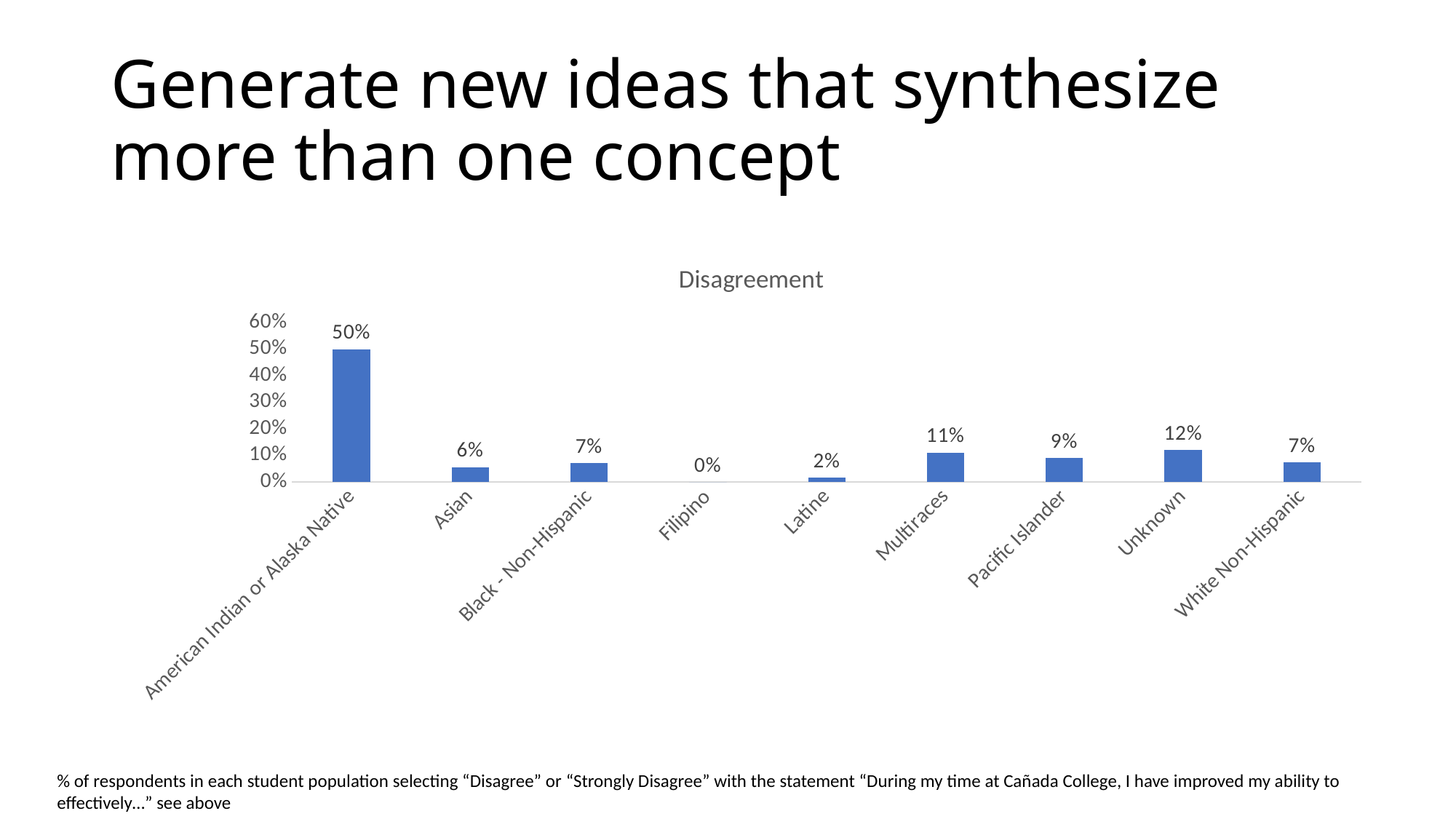
What is the value for Multiraces? 11% Which category has the lowest value? Filipino What is the value for American Indian or Alaska Native? 50% What is the value for Latine? 2% What kind of chart is shown? bar chart What is the difference between the values for Multiraces and White Non-Hispanic? 4% What is the difference between the values for Unknown and Asian? 6% How many categories are shown on the x axis? 9 What is the title of the chart? Disagreement Which category has the highest value? American Indian or Alaska Native Which is larger, the value for Pacific Islander or the value for Black - Non-Hispanic? Pacific Islander Is the value for American Indian or Alaska Native greater or less than 40%? greater